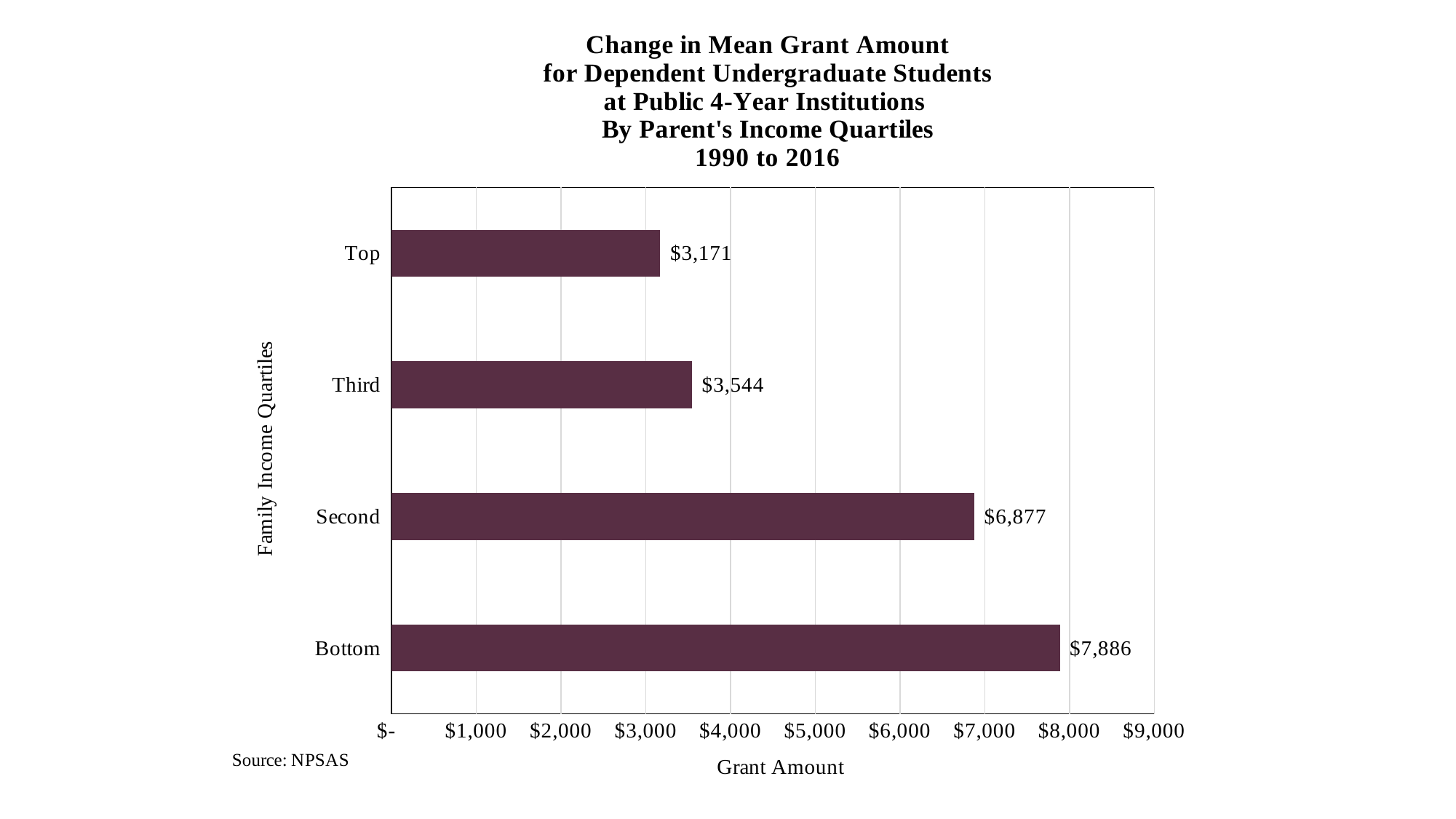
Which income quartile has the smallest change in mean grant amount? Top What type of chart is shown on the slide? Bar chart What is the label of the horizontal axis? Grant Amount What is the difference between the change in mean grant amount for the Bottom and Top quartiles? $4,715 Which income quartile has the largest change in mean grant amount? Bottom How many income quartiles are shown on the chart? 4 Which has a larger change in mean grant amount, the Third quartile or the Top quartile? Third What is the change in mean grant amount for the Third income quartile? $3,544 What is the change in mean grant amount for the Top income quartile? $3,171 What is the change in mean grant amount for the Second income quartile? $6,877 What is the change in mean grant amount for the Bottom income quartile? $7,886 What is the difference between the change in mean grant amount for the Second and Third quartiles? $3,333